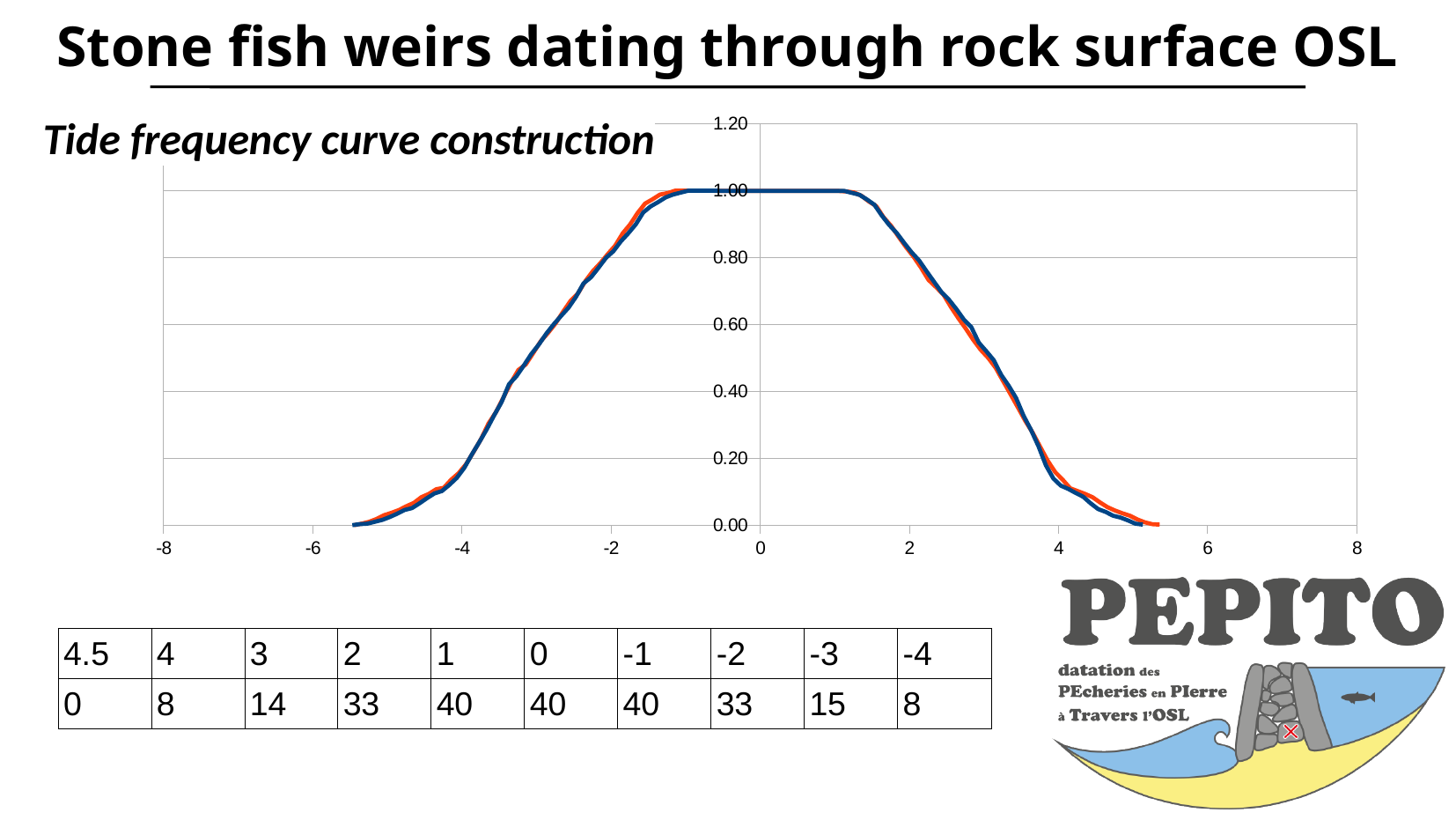
Is the value of the curves at x = -2 greater or less than 0.60? greater Which is larger, the value of the curves at x = -2 or at x = -4? x = -2 Is the value of the curves at x = 0 greater or less than 0.80? greater Do the curves rise or fall as the x axis goes from -4 to 0? rise Do the curves rise or fall as the x axis goes from 2 to 4? fall How many lines are plotted on the chart? 2 Is the value of the curves at x = -4 greater or less than 0.20? less What kind of chart is shown on the slide? line chart What is the highest value shown on the y axis of the chart? 1.20 What colours are the two lines on the chart? orange and blue